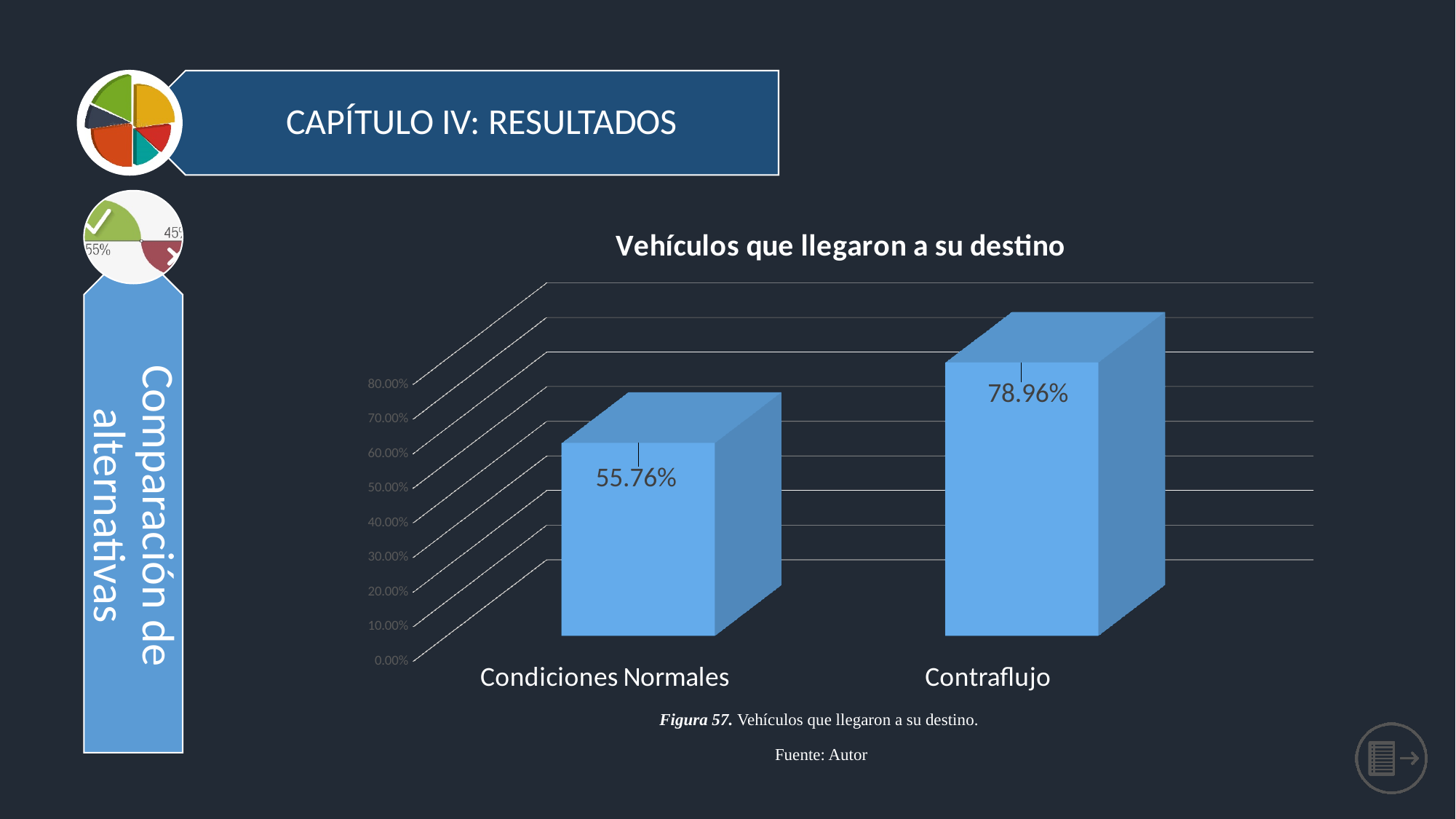
Is the value for Condiciones Normales greater or less than 60.00%? less What is the difference between the values for Contraflujo and Condiciones Normales? 23.20% What is the title of the chart? Vehículos que llegaron a su destino Which is larger, the value for Condiciones Normales or the value for Contraflujo? Contraflujo Which category has the highest value? Contraflujo Is the value for Contraflujo greater or less than 70.00%? greater Which category has the lowest value? Condiciones Normales What kind of chart is shown on the slide? bar chart What is the highest value shown on the vertical axis? 80.00% What is the value for Contraflujo? 78.96% What is the value for Condiciones Normales? 55.76% How many categories are shown in the chart? 2